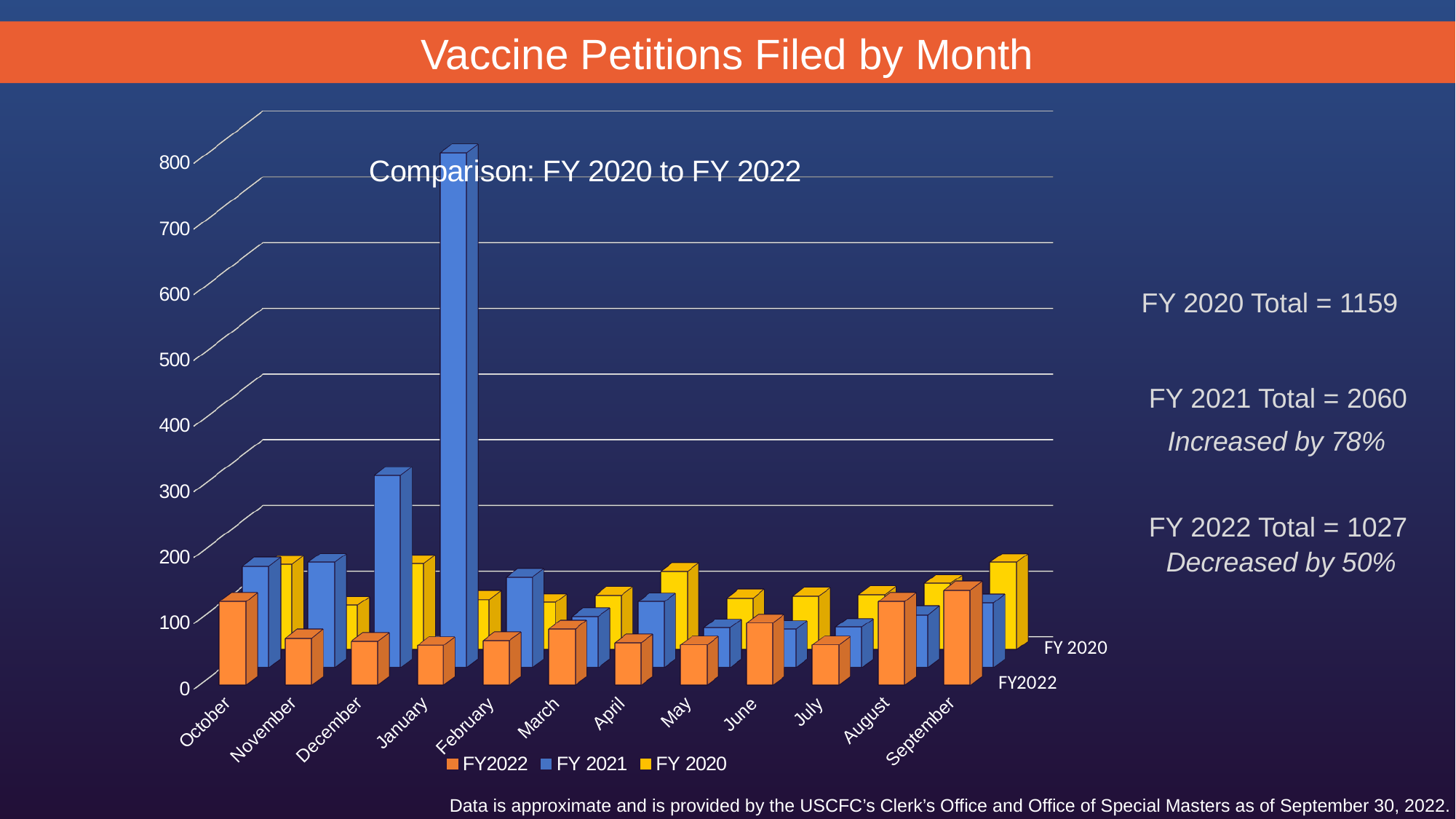
What kind of chart is shown on the slide? bar chart Is the FY 2020 value for September greater or less than 100? greater Is the FY 2021 value for January greater or less than 200? greater How many months are shown on the x axis of the chart? 12 Which is larger for FY 2021: the value for January or the value for February? January What is the title of the chart on the slide? Comparison: FY 2020 to FY 2022 Which colour represents the FY 2020 series in the chart? yellow How many series does the chart's legend list? 3 Is the FY 2021 value for February greater or less than 600? less Which month has the highest value for the FY 2021 series? January For October, which series has the larger value: FY2022 or FY 2021? FY 2021 Which is larger: the FY 2020 value for September or the FY2022 value for July? FY 2020 value for September